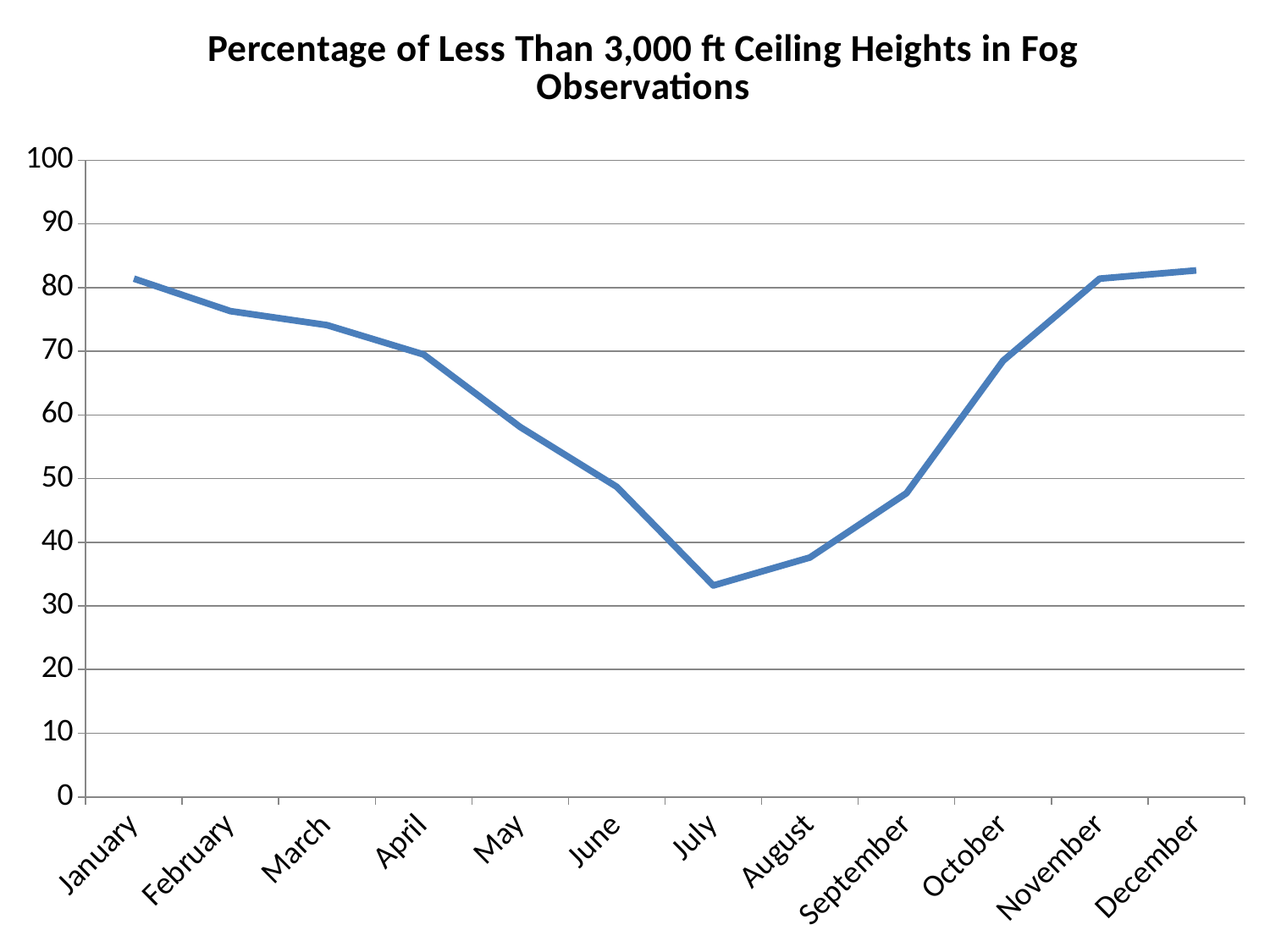
How many months are plotted along the x axis? 12 What kind of chart is shown on the slide? line chart Which month has the lowest percentage? July What is the title of the chart? Percentage of Less Than 3,000 ft Ceiling Heights in Fog Observations Which is larger, the value for January or the value for July? January Which is larger, the value for May or the value for October? October Is the value for May greater or less than 50? greater Do the values rise or fall from January to July? fall Is the value for July greater or less than 40? less Is the value for August greater or less than 50? less